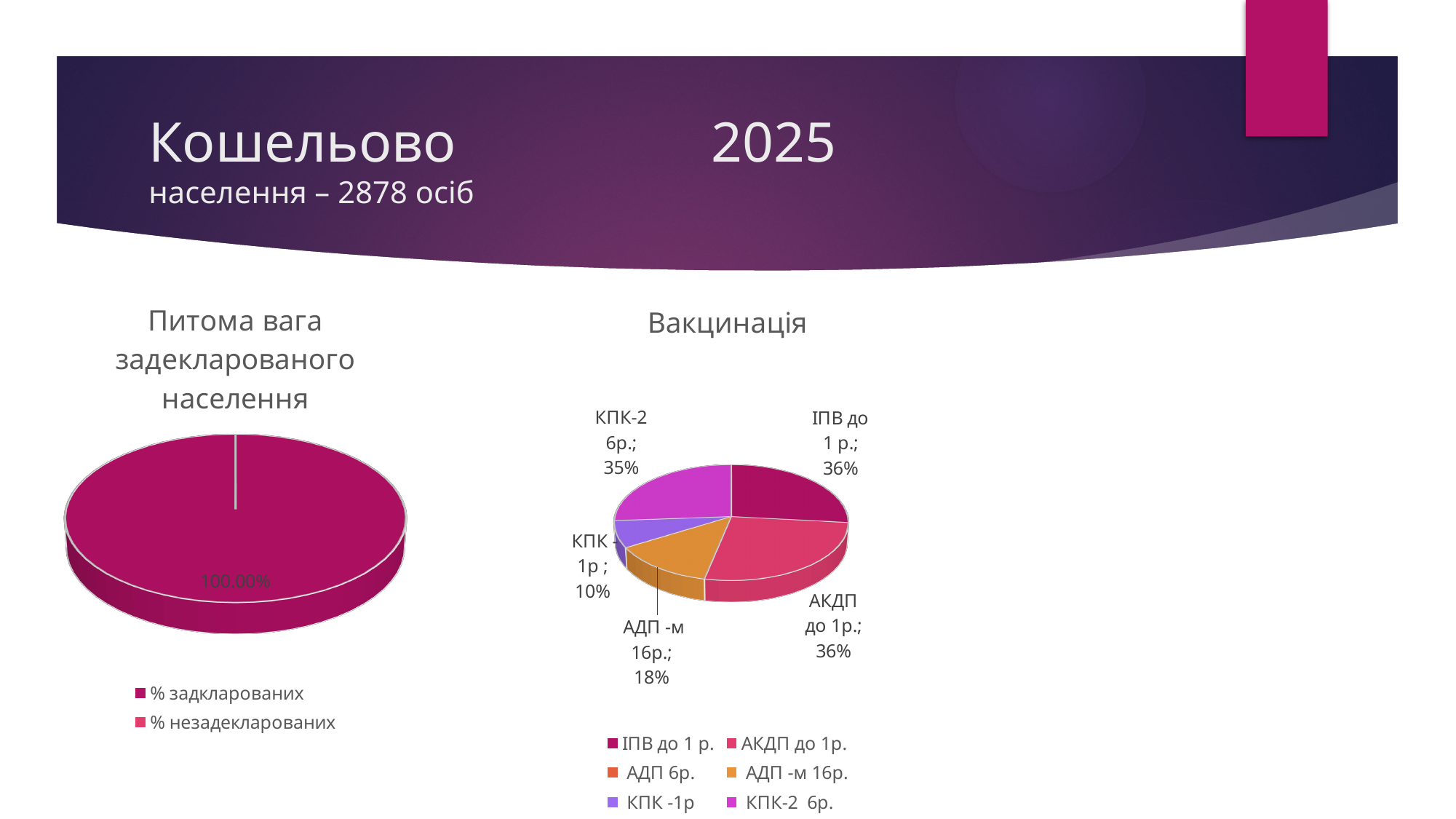
What is the title of the chart on the right side of the slide? Вакцинація How many entries does the legend of the 'Вакцинація' chart list? 6 In the 'Вакцинація' chart, what is the value for 'КПК -1р'? 10% In the 'Питома вага задекларованого населення' chart, what is the value for '% задклярованих'? 100.00% In the 'Вакцинація' chart, what is the value for 'КПК-2 6р.'? 35% In the 'Вакцинація' chart, what is the value for 'ІПВ до 1 р.'? 36% In the 'Вакцинація' chart, which is larger: 'КПК-2 6р.' or 'АДП -м 16р.'? КПК-2 6р. In the 'Вакцинація' chart, what is the value for 'АДП -м 16р.'? 18% In the 'Вакцинація' chart, what is the difference between 'КПК-2 6р.' and 'АДП -м 16р.'? 17 percentage points What kind of chart is the 'Вакцинація' chart? pie chart How many entries does the legend of the 'Питома вага задекларованого населення' chart list? 2